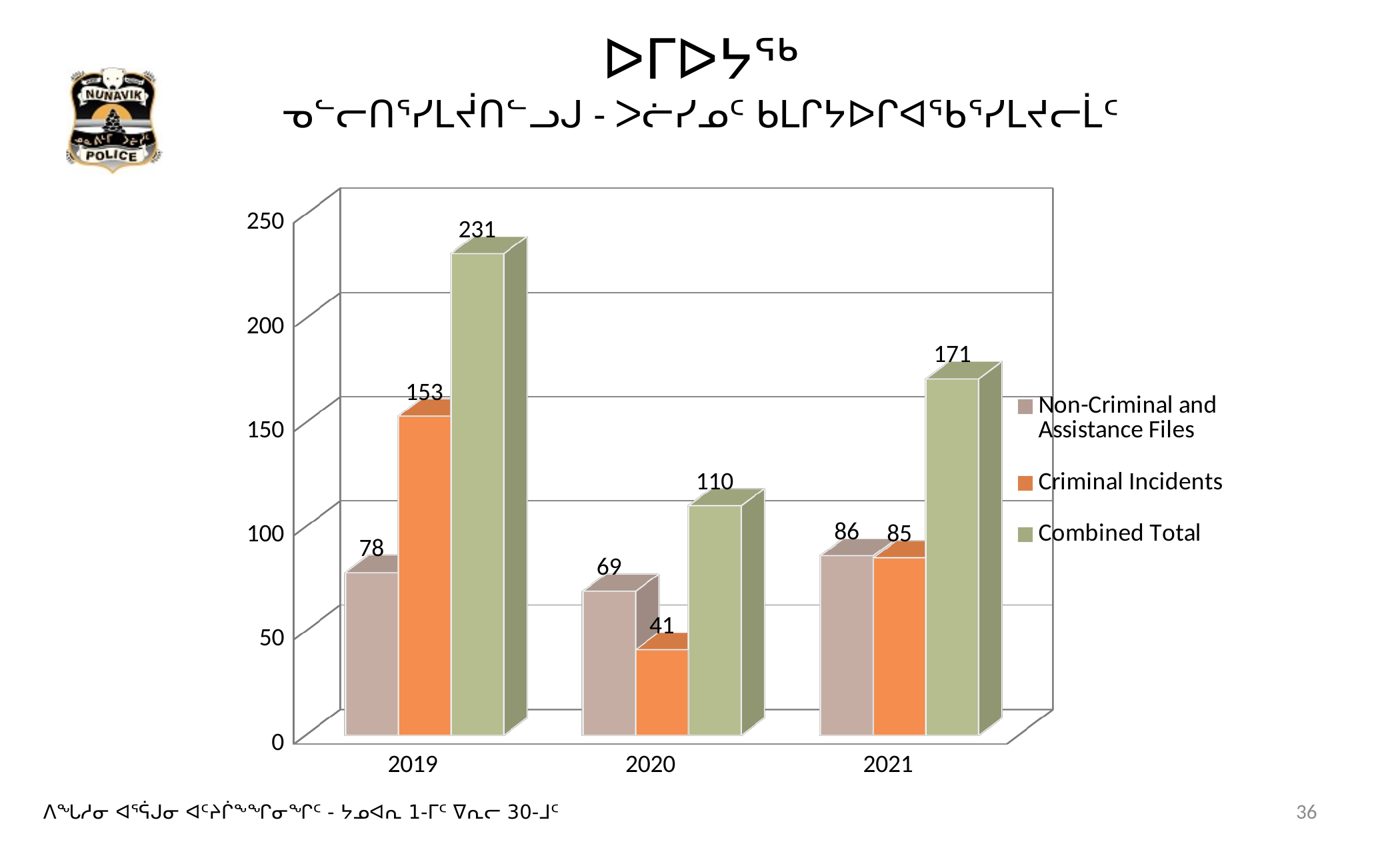
What is the difference between the Combined Total in 2019 and in 2020? 121 What is the value for Criminal Incidents in 2020? 41 What is the value for Criminal Incidents in 2019? 153 Which year has the highest Combined Total? 2019 What is the value for Non-Criminal and Assistance Files in 2020? 69 Which colour represents Combined Total in the legend? Green What kind of chart is shown on the slide? Bar chart What is the Combined Total for 2021? 171 How many series does the legend list? 3 How many years are shown on the x axis? 3 Which year has the lowest value for Criminal Incidents? 2020 Which is larger in 2019: Non-Criminal and Assistance Files or Criminal Incidents? Criminal Incidents